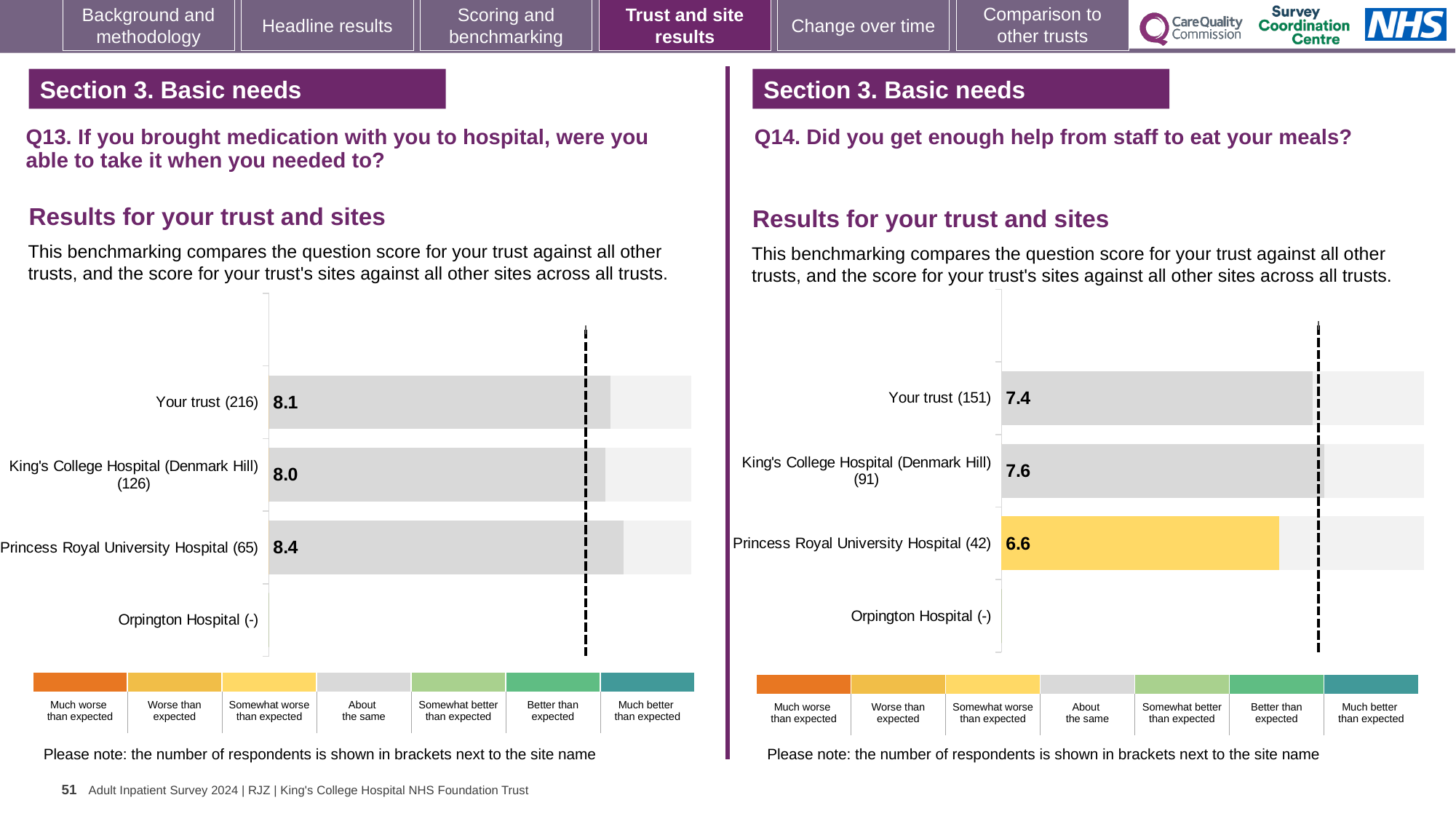
On the Q14 chart (right), which has the higher score, Your trust or King's College Hospital (Denmark Hill)? King's College Hospital (Denmark Hill) On the Q14 chart (right), how many respondents are shown in brackets for Your trust? 151 On the Q14 chart (right), what is the difference between the scores for Your trust and Princess Royal University Hospital? 0.8 On the Q13 chart (left), what is the difference between the scores for Princess Royal University Hospital and King's College Hospital (Denmark Hill)? 0.4 On the Q13 chart (left), what is the score for Your trust? 8.1 What kind of chart is used on the Q13 chart (left)? Bar chart On the Q13 chart (left), which site or trust row has the highest score? Princess Royal University Hospital On the Q14 chart (right), which site or trust row has the lowest score? Princess Royal University Hospital On the Q14 chart (right), which site's bar is coloured yellow rather than grey? Princess Royal University Hospital On the Q14 chart (right), what is the score for Princess Royal University Hospital? 6.6 On the Q13 chart (left), what is the score for Princess Royal University Hospital? 8.4 On the Q14 chart (right), what is the score for King's College Hospital (Denmark Hill)? 7.6